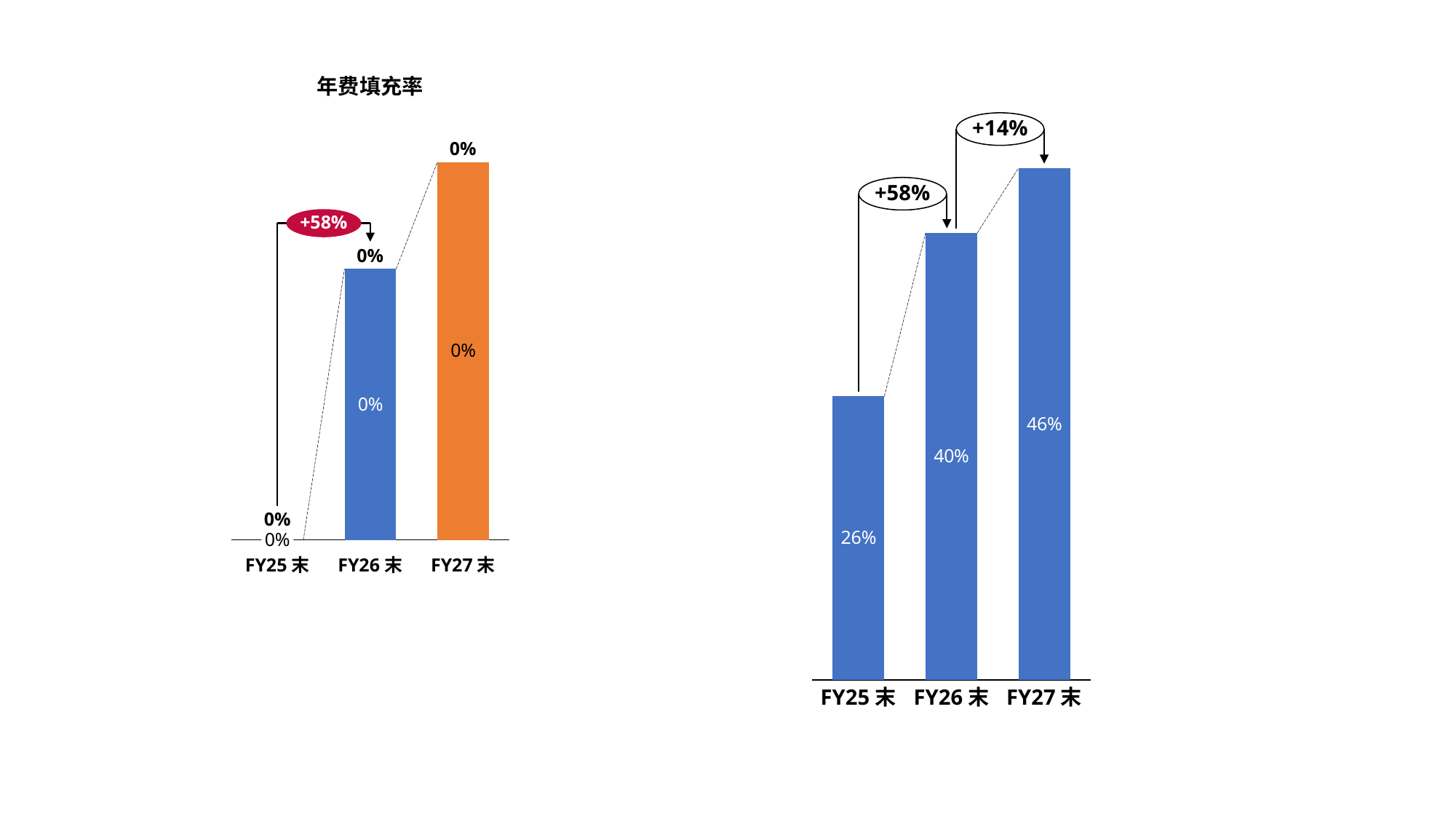
In the chart on the right, how many bars are plotted? 3 In the chart on the right, what is the value for FY25 末? 26% In the chart on the right, what growth percentage is annotated between FY26 末 and FY27 末? +14% In the chart on the right, do the values rise or fall from FY25 末 to FY27 末? rise In the chart on the right, what is the value for FY27 末? 46% In the chart on the right, which category has the lowest value? FY25 末 In the chart on the right, which is larger, the value for FY26 末 or FY25 末? FY26 末 In the chart on the right, which category has the highest value? FY27 末 What is the title of the chart on the left? 年费填充率 In the chart on the right, what is the value for FY26 末? 40% What kind of chart is the chart on the left? bar chart In the chart on the right, what is the difference between the values for FY27 末 and FY25 末? 20 percentage points